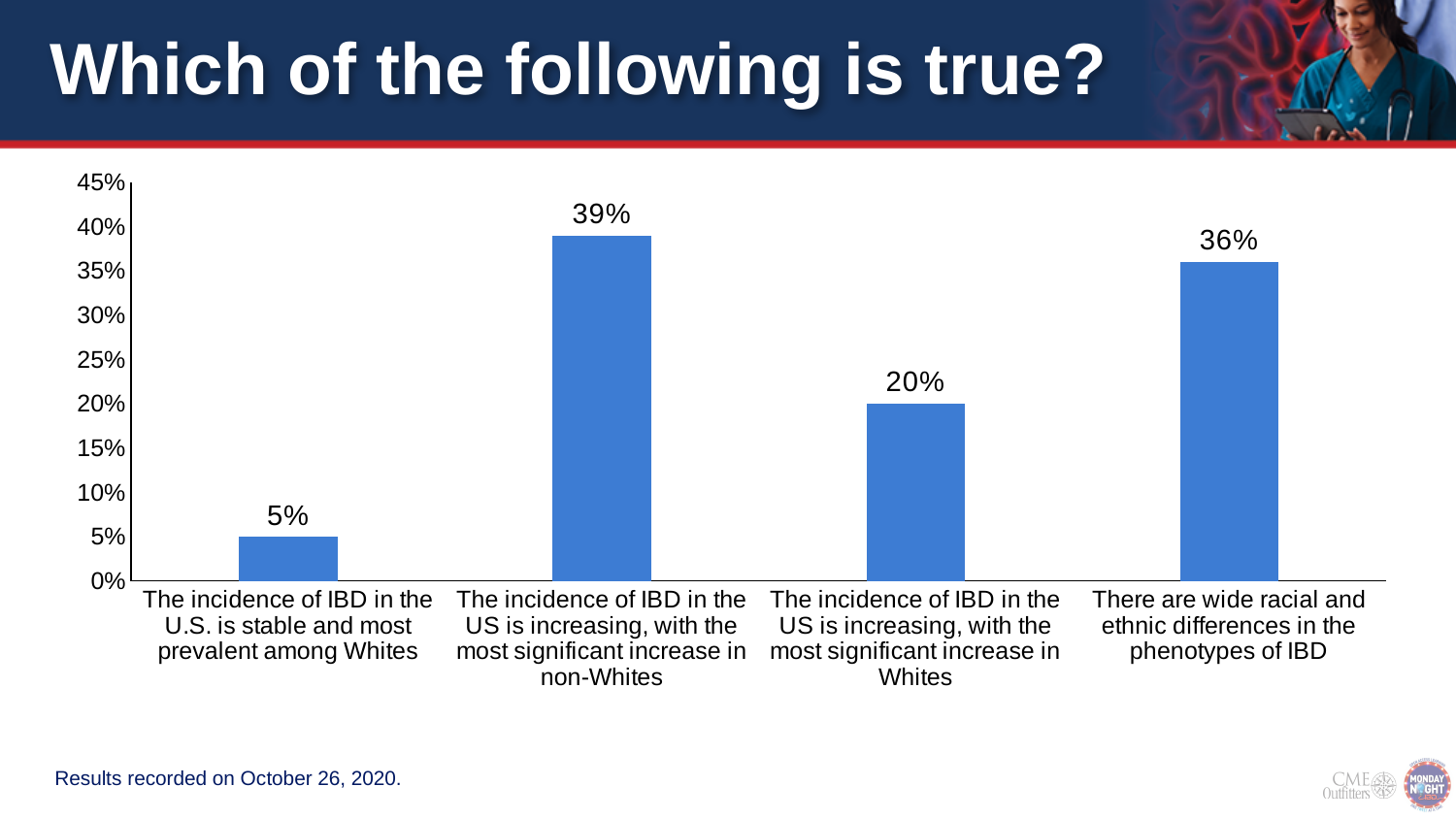
What percentage of respondents chose "There are wide racial and ethnic differences in the phenotypes of IBD"? 36% Which received a larger share of responses: the "wide racial and ethnic differences" option or the "increasing in Whites" option? There are wide racial and ethnic differences in the phenotypes of IBD What percentage of respondents chose "The incidence of IBD in the US is increasing, with the most significant increase in Whites"? 20% How many answer options are shown in the chart? 4 What percentage of respondents chose "The incidence of IBD in the US is increasing, with the most significant increase in non-Whites"? 39% What percentage of respondents chose "The incidence of IBD in the U.S. is stable and most prevalent among Whites"? 5% Which answer option received the highest percentage of responses? The incidence of IBD in the US is increasing, with the most significant increase in non-Whites What is the maximum value shown on the vertical axis? 45% What is the difference in percentage points between the "non-Whites" option and the "Whites" increasing option? 19 percentage points Which answer option received the lowest percentage of responses? The incidence of IBD in the U.S. is stable and most prevalent among Whites Is the value for "There are wide racial and ethnic differences in the phenotypes of IBD" greater or less than 30%? greater What type of chart is shown on the slide? Bar chart